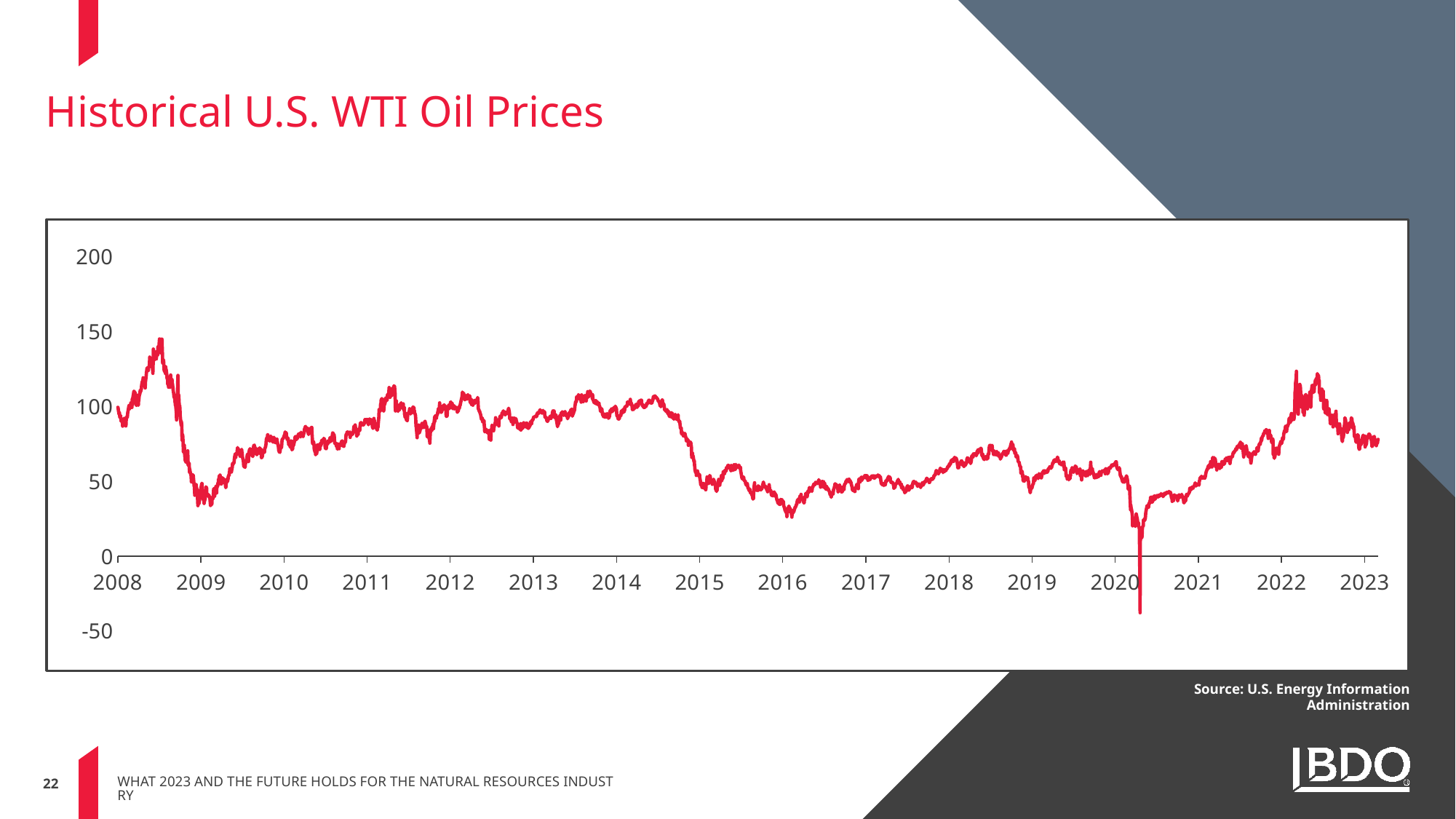
What kind of chart is shown on the slide? line chart What source is cited for the chart? U.S. Energy Information Administration In which year does the line reach its lowest point? 2020 Is the peak value in 2022 greater or less than 150? less Is the peak value in 2008 greater or less than 100? greater Which peak is higher, the one in 2008 or the one in 2022? 2008 Is the lowest point of the line in 2020 greater or less than 0? less Does the line rise or fall from the middle of 2014 to the start of 2016? fall In which year does the line reach its highest peak? 2008 What is the title of the chart on the slide? Historical U.S. WTI Oil Prices